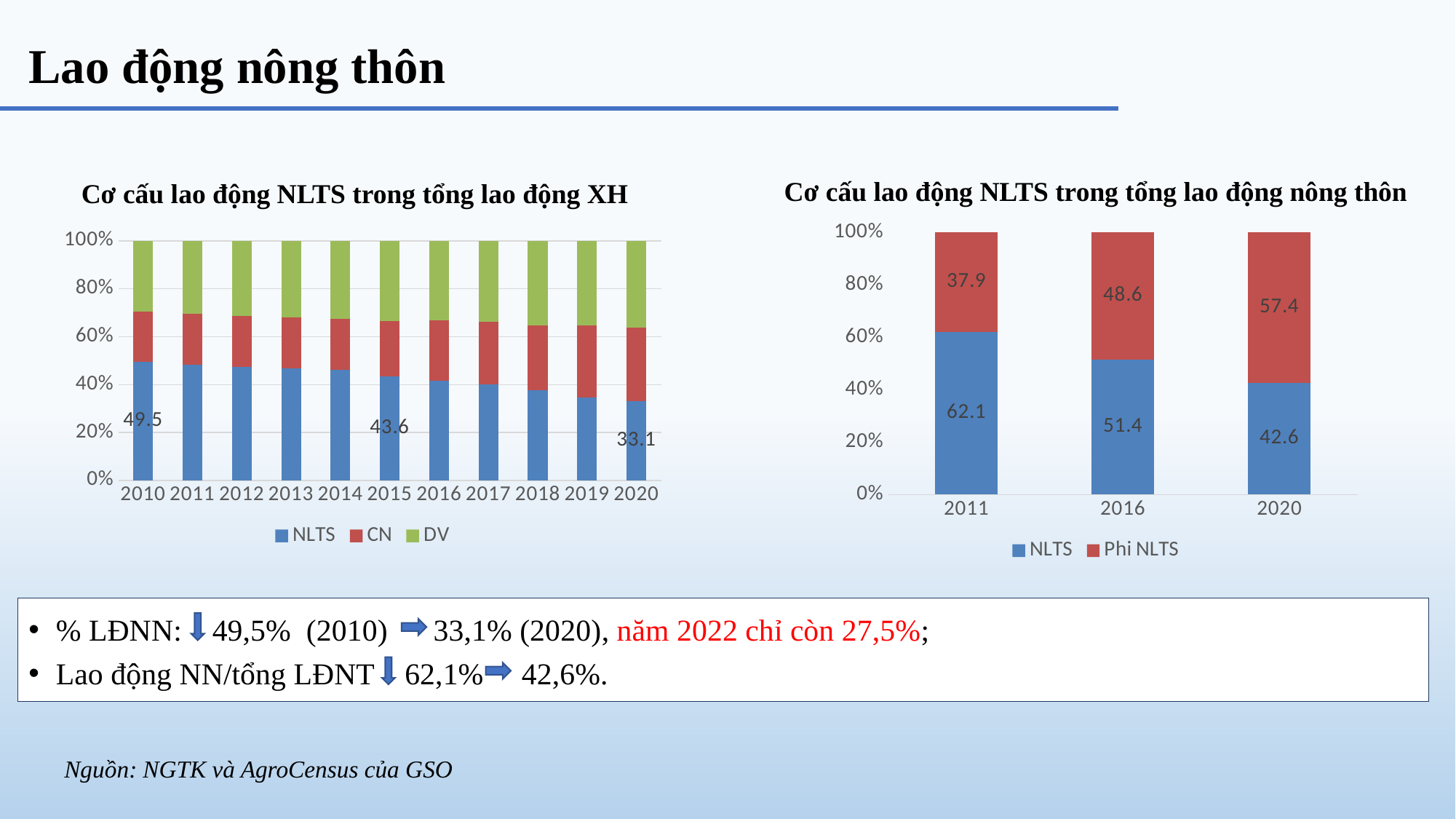
In the chart titled 'Cơ cấu lao động NLTS trong tổng lao động XH', what is the difference between the NLTS values for 2010 and 2015? 5.9 In the chart titled 'Cơ cấu lao động NLTS trong tổng lao động nông thôn', what is the Phi NLTS value for 2020? 57.4 In the chart titled 'Cơ cấu lao động NLTS trong tổng lao động XH', does the NLTS share rise or fall from 2010 to 2020? fall In the chart titled 'Cơ cấu lao động NLTS trong tổng lao động nông thôn', which year has the highest NLTS value? 2011 In the chart titled 'Cơ cấu lao động NLTS trong tổng lao động XH', what is the NLTS value for 2010? 49.5 In the chart titled 'Cơ cấu lao động NLTS trong tổng lao động XH', what is the NLTS value for 2020? 33.1 What kind of chart is the one titled 'Cơ cấu lao động NLTS trong tổng lao động nông thôn'? Stacked bar chart In the chart titled 'Cơ cấu lao động NLTS trong tổng lao động XH', how many series does the legend list? 3 In the chart titled 'Cơ cấu lao động NLTS trong tổng lao động nông thôn', which is larger in 2016: NLTS or Phi NLTS? NLTS In the chart titled 'Cơ cấu lao động NLTS trong tổng lao động XH', how many years are shown on the x axis? 11 In the chart titled 'Cơ cấu lao động NLTS trong tổng lao động nông thôn', what is the difference between the NLTS values for 2011 and 2020? 19.5 In the chart titled 'Cơ cấu lao động NLTS trong tổng lao động nông thôn', what is the NLTS value for 2016? 51.4